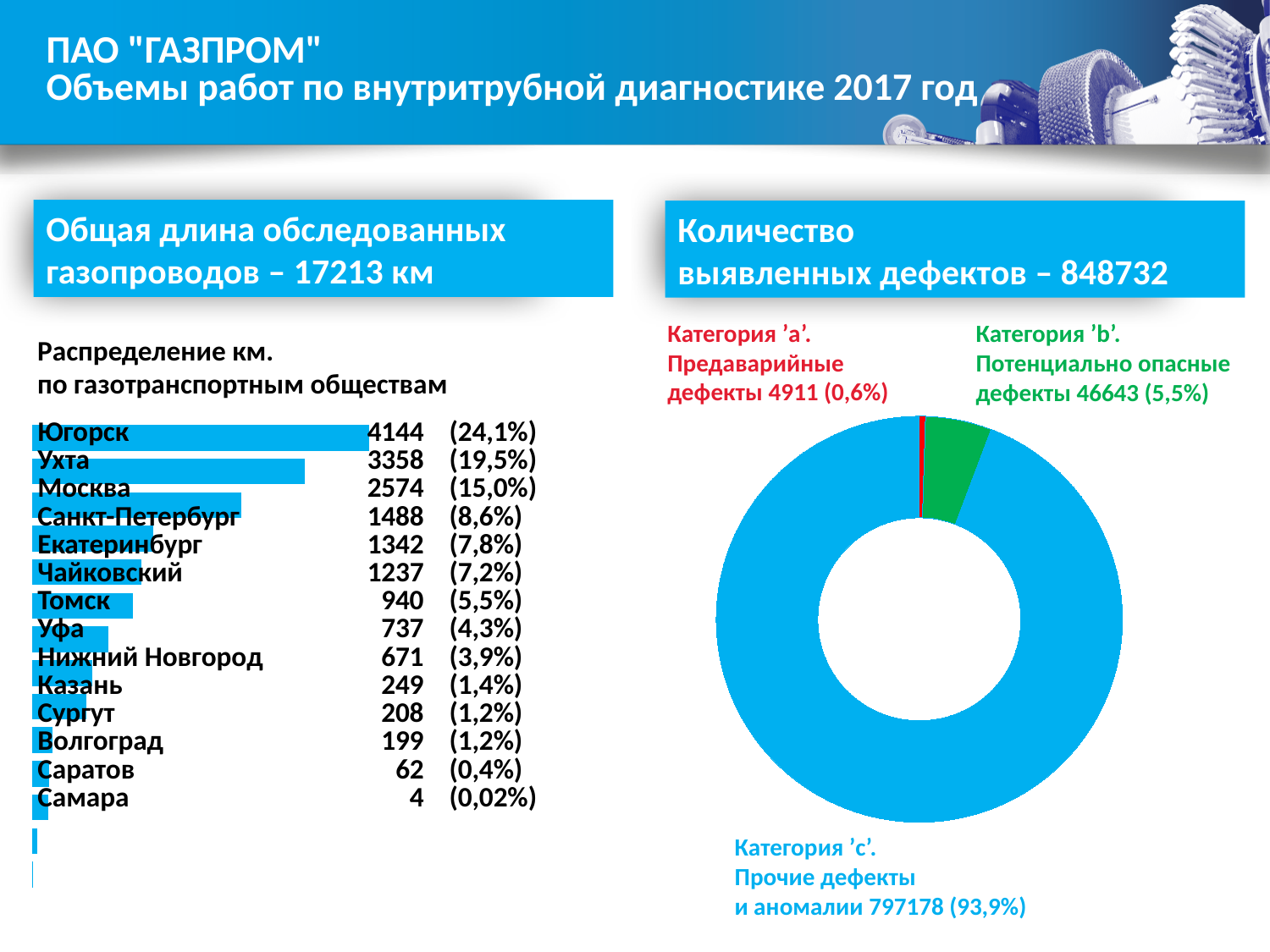
On the right doughnut chart, which category has the smallest value? Категория 'a' On the left bar chart, what is the difference between the values for Ухта and Москва? 784 On the left bar chart (Распределение км. по газотранспортным обществам), what is the value for Югорск? 4144 On the right doughnut chart (Количество выявленных дефектов), what is the value for Категория 'b' (Потенциально опасные дефекты)? 46643 On the right doughnut chart, what share does Категория 'c' (Прочие дефекты и аномалии) have? 93,9% What kind of chart is the one on the left of the slide? Bar chart On the left bar chart, which category has the highest value? Югорск What kind of chart is the one on the right of the slide? Doughnut chart How many categories does the left bar chart show? 14 On the left bar chart, which category has the lowest value? Самара On the left bar chart, which is larger, the value for Екатеринбург or the value for Чайковский? Екатеринбург On the left bar chart, what is the value for Томск? 940